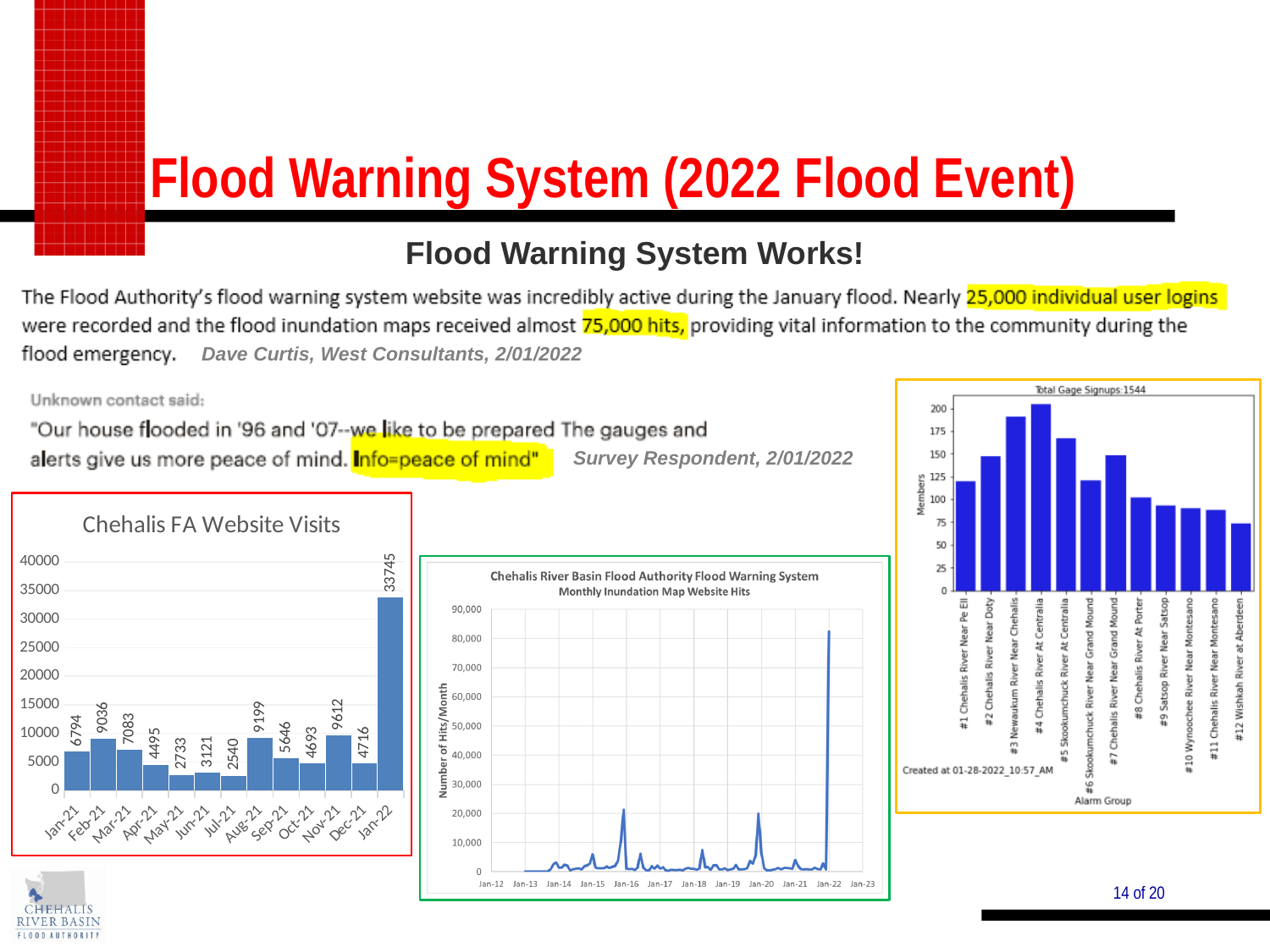
How many months are shown in the Chehalis FA Website Visits chart? 13 In the Total Gage Signups chart, which alarm group has the most members? #4 Chehalis River At Centralia In the Chehalis FA Website Visits chart, what is the difference between the values for Nov-21 and Dec-21? 4896 In the Chehalis FA Website Visits chart, what is the value for Jan-22? 33745 In the Chehalis FA Website Visits chart, what is the value for Aug-21? 9199 In the Chehalis FA Website Visits chart, which is larger, the value for Feb-21 or the value for Mar-21? Feb-21 In the Total Gage Signups chart, is the value for #1 Chehalis River Near Pe Ell greater or less than 100? greater In the Chehalis FA Website Visits chart, which month has the highest value? Jan-22 In the Chehalis FA Website Visits chart, which month has the lowest value? Jul-21 What kind of chart is the Monthly Inundation Map Website Hits chart? line chart In the Total Gage Signups chart, which alarm group has the fewest members? #12 Wishkah River at Aberdeen What kind of chart is the Chehalis FA Website Visits chart? bar chart